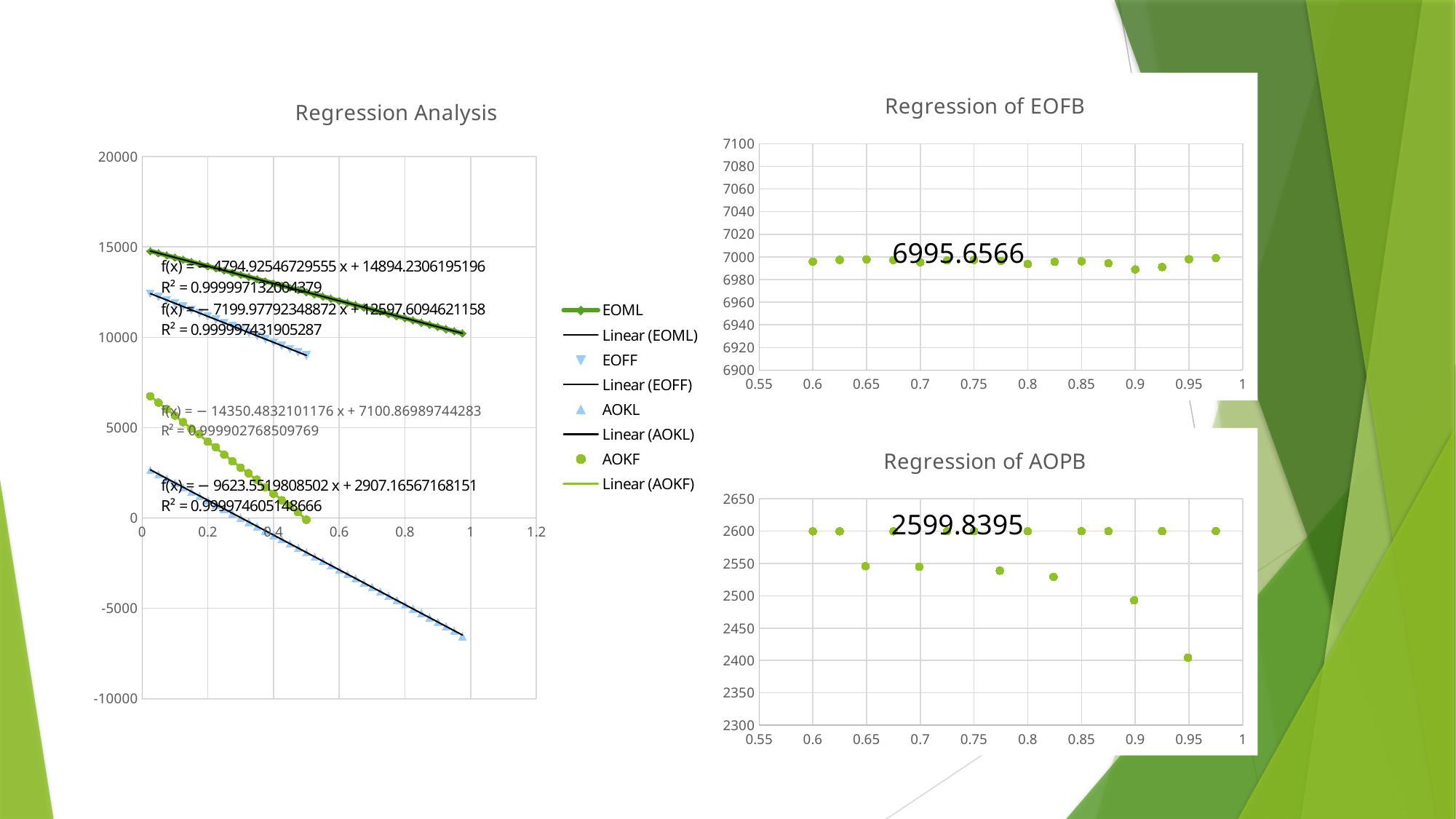
On the 'Regression Analysis' chart, how many entries does the legend list? 8 On the 'Regression of AOPB' chart, at which x value is the lowest point plotted? 0.95 On the 'Regression Analysis' chart, which series has the highest plotted values? EOML On the 'Regression Analysis' chart, do the plotted values rise or fall as x increases? fall On the 'Regression Analysis' chart, what is the intercept in the trendline equation f(x) = −9623.5519808502 x + ...? 2907.16567168151 On the 'Regression of AOPB' chart, what value is printed as the data label? 2599.8395 On the 'Regression Analysis' chart, what is the R² value shown for the trendline with equation f(x) = −4794.92546729555 x + 14894.2306195196? 0.999997132004379 On the 'Regression Analysis' chart, what kind of chart is it? scatter chart On the 'Regression of EOFB' chart, what value is printed as the data label? 6995.6566 On the 'Regression Analysis' chart, which series drops below 0 on the y axis? AOKL On the 'Regression of EOFB' chart, is the value at x = 0.9 greater or less than 7000? less On the 'Regression of AOPB' chart, is the value at x = 0.95 greater or less than 2450? less